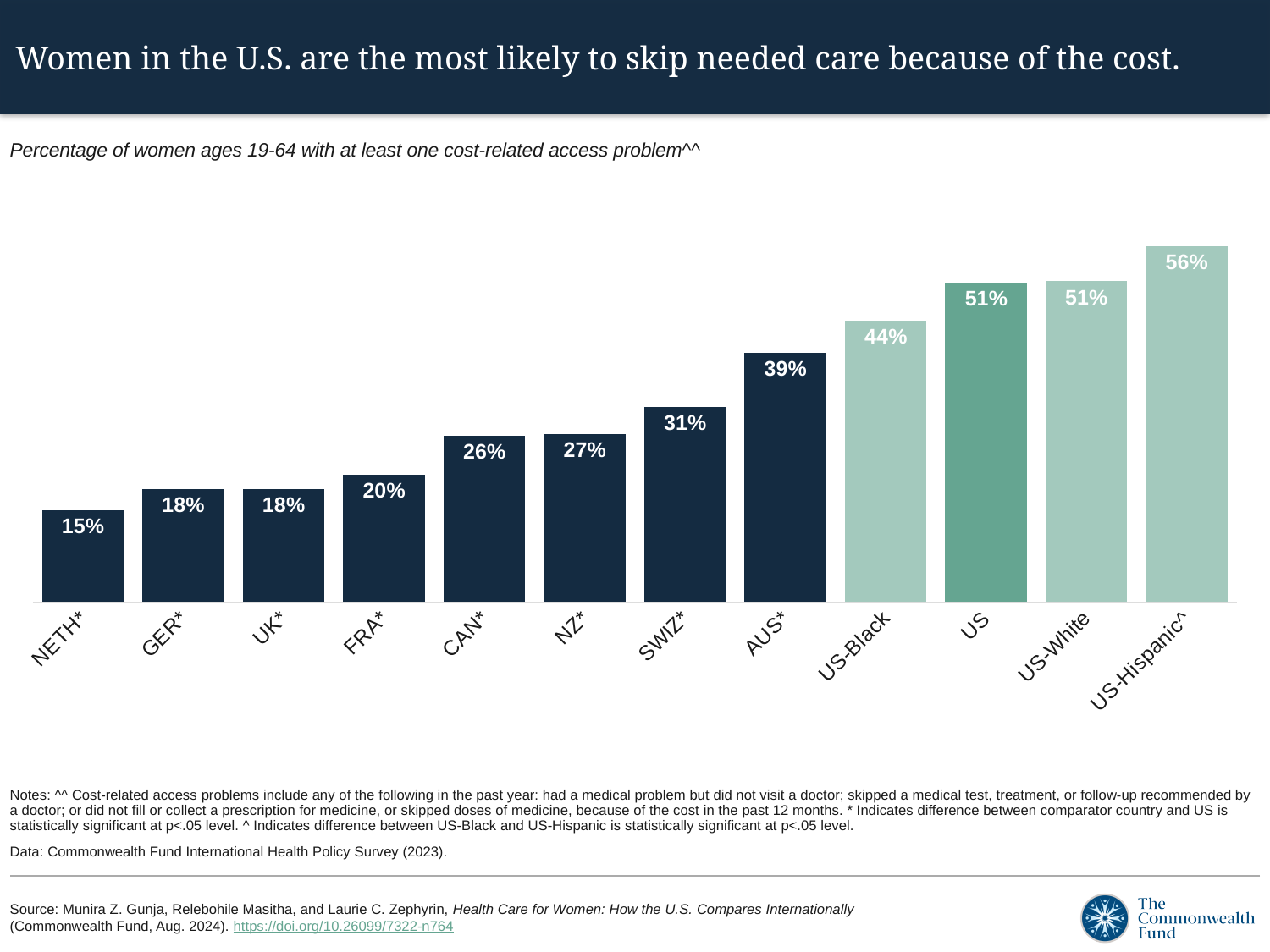
Which is larger, the value for SWIZ* or the value for CAN*? SWIZ* What is the value for NETH*? 15% Which category has the lowest value? NETH* What kind of chart is shown on the slide? Bar chart Do the values generally rise or fall from left to right along the x axis? Rise How many categories are shown on the chart? 12 Which category has the highest value? US-Hispanic^ What is the value for US-Black? 44% What is the subtitle describing what the chart measures? Percentage of women ages 19-64 with at least one cost-related access problem^^ What is the value for AUS*? 39% What is the difference between the values for US and NETH*? 36% What is the difference between the values for US-Hispanic^ and US-Black? 12%